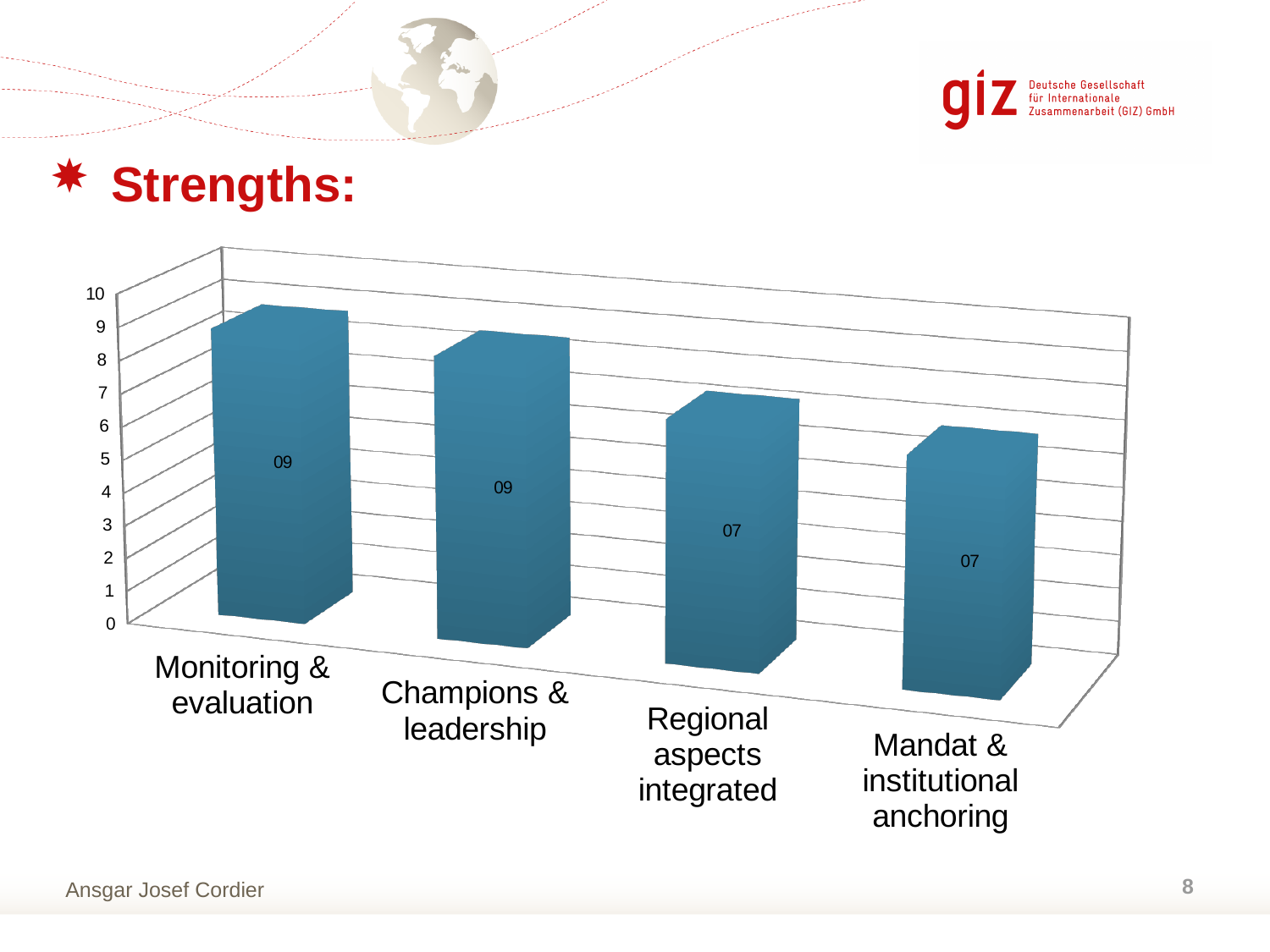
What kind of chart is shown on the slide? bar chart Which is larger, the value for Monitoring & evaluation or the value for Regional aspects integrated? Monitoring & evaluation How many categories are shown on the x axis? 4 What is the heading shown above the chart? Strengths: Is the value for Regional aspects integrated greater or less than 5? greater What is the value for Mandat & institutional anchoring? 07 What is the difference between the value for Champions & leadership and the value for Mandat & institutional anchoring? 2 Do the values rise or fall from left to right along the x axis? fall What is the value for Monitoring & evaluation? 09 What is the value for Champions & leadership? 09 Which is larger, the value for Mandat & institutional anchoring or the value for Champions & leadership? Champions & leadership What is the value for Regional aspects integrated? 07